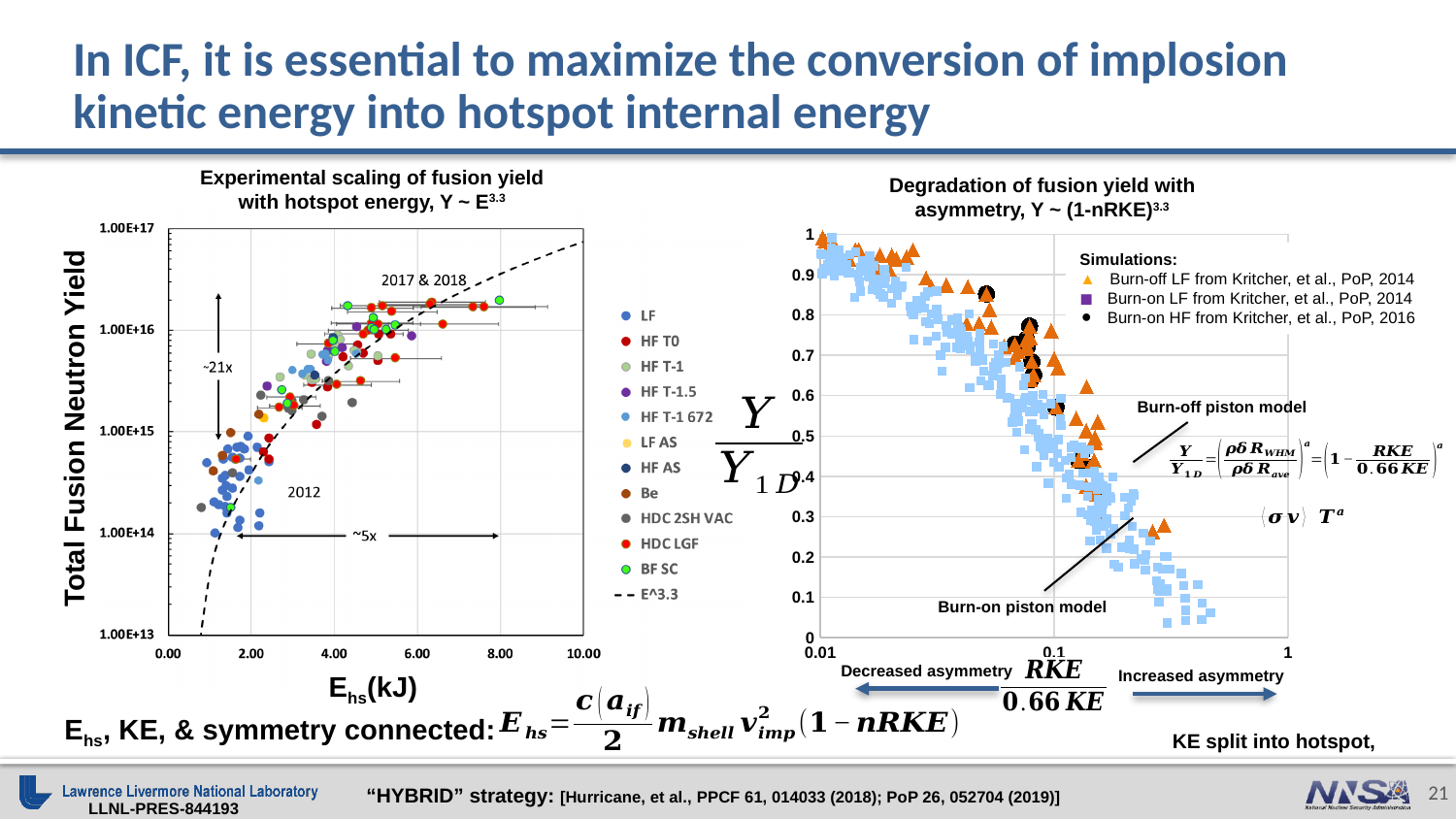
What kind of chart is the right chart titled 'Degradation of fusion yield with asymmetry'? scatter chart In the right chart (Degradation of fusion yield with asymmetry), which legend entry is from Kritcher, et al., PoP, 2016? Burn-on HF In the left chart (Experimental scaling of fusion yield), how many entries does the legend list? 12 What kind of chart is the left chart titled 'Experimental scaling of fusion yield with hotspot energy'? scatter chart In the left chart (Experimental scaling of fusion yield), what is the label of the y axis? Total Fusion Neutron Yield In the left chart (Experimental scaling of fusion yield), does the total fusion neutron yield rise or fall as E_hs increases? rise In the right chart (Degradation of fusion yield with asymmetry), how many simulation series does the legend list? 3 In the right chart (Degradation of fusion yield with asymmetry), does Y/Y_1D rise or fall as RKE/0.66KE increases along the x axis? fall